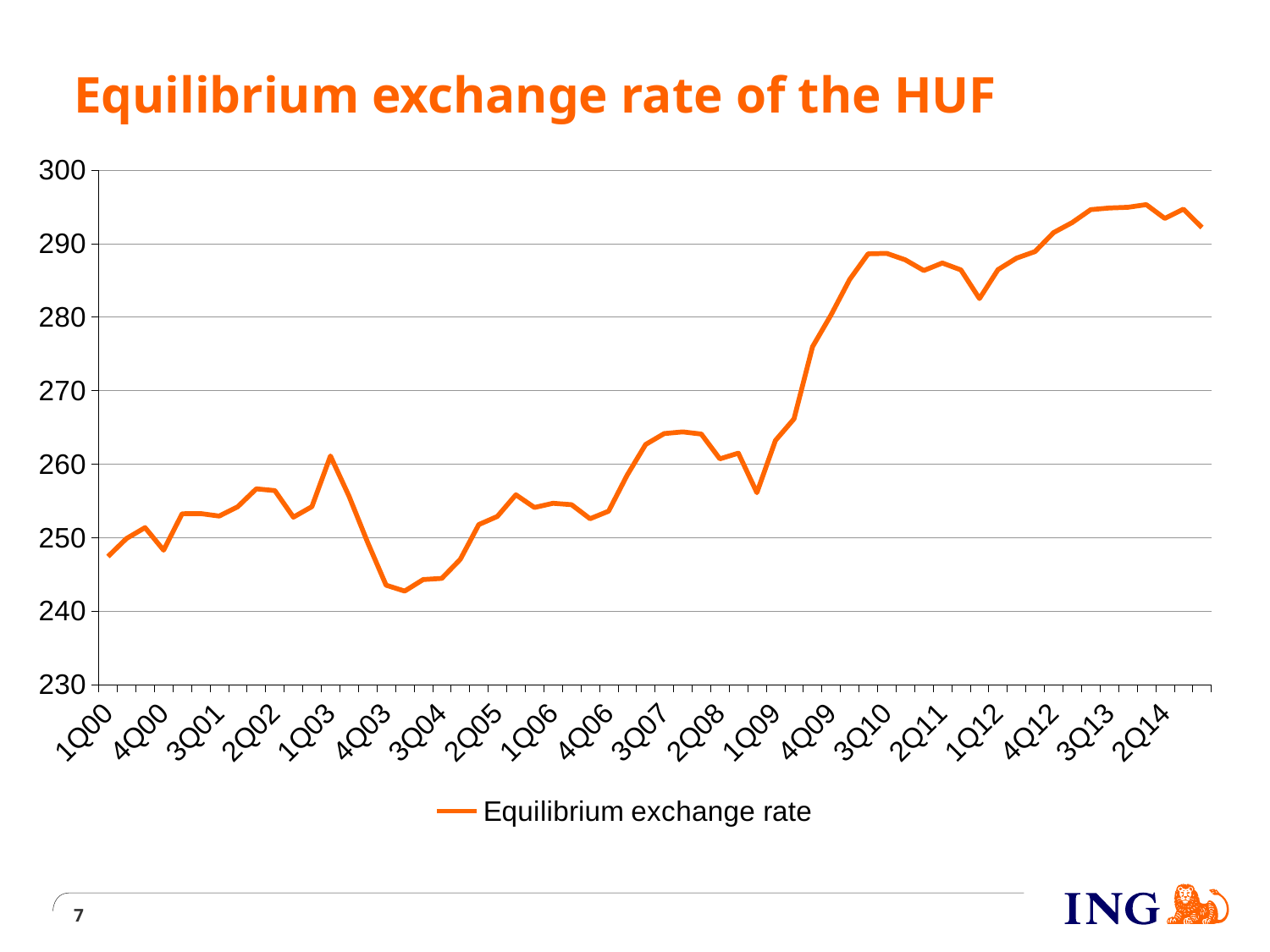
Is the value for 3Q13 greater or less than 290? greater Is the value for 4Q03 greater or less than 250? less How many series does the legend list? 1 Is the value for 4Q09 greater or less than 270? greater Does the equilibrium exchange rate rise or fall overall from 1Q00 to 2Q14? rise What is the title of the chart? Equilibrium exchange rate of the HUF What is the legend entry for the plotted line? Equilibrium exchange rate Which is larger, the value for 4Q03 or the value for 3Q10? 3Q10 What kind of chart is shown on the slide? Line chart Does the line rise or fall between 1Q03 and 4Q03? fall